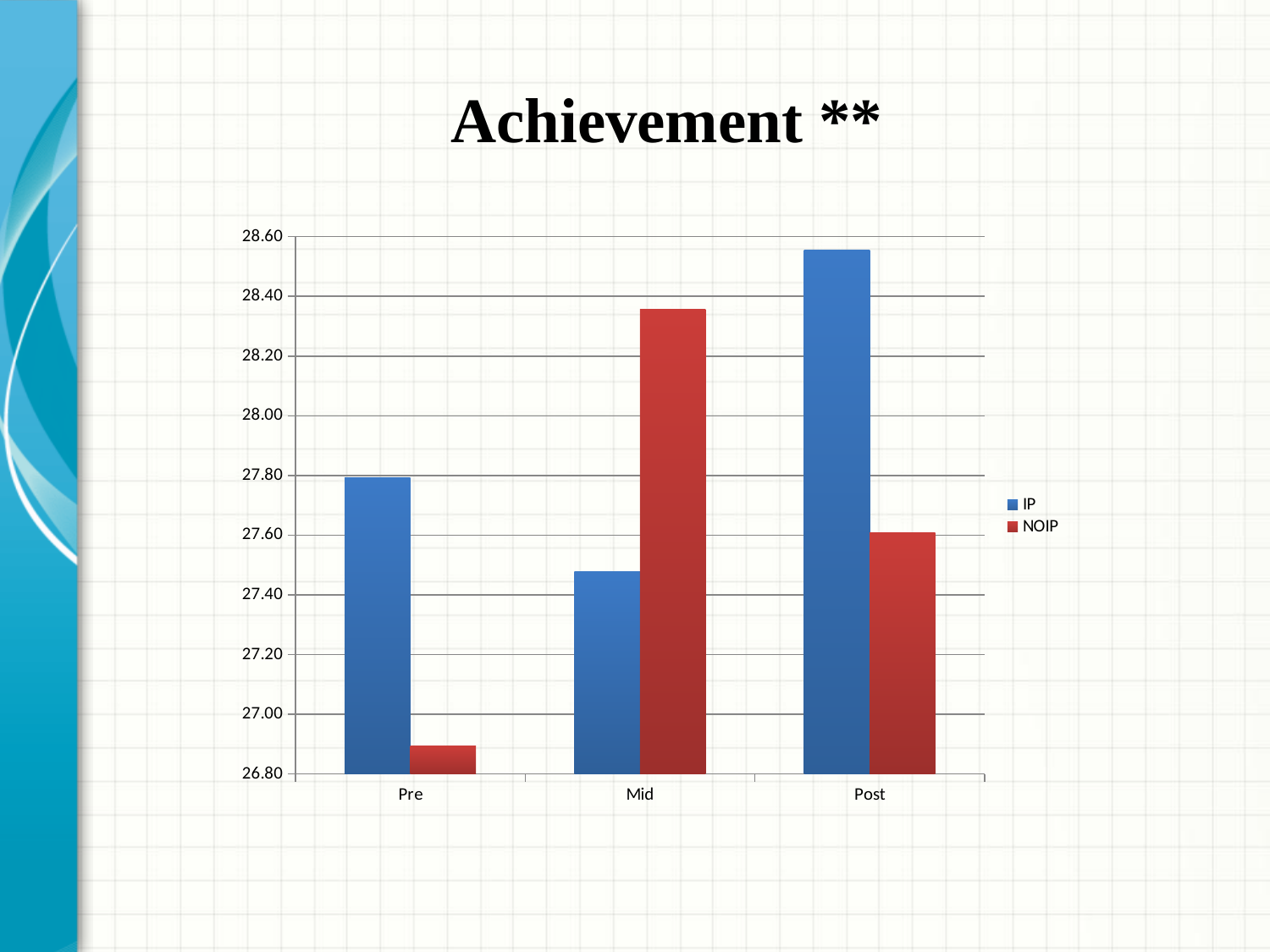
Which category has the highest value for the IP series? Post Is the value for NOIP at Pre greater or less than 27.00? less Which category has the lowest value for the NOIP series? Pre At Post, which series has the larger value, IP or NOIP? IP Which category has the lowest value for the IP series? Mid What kind of chart is shown on the slide? bar chart At Mid, which series has the larger value, IP or NOIP? NOIP What is the title of the chart? Achievement ** Is the value for IP at Post greater or less than 28.40? greater How many categories are shown on the x axis? 3 How many series does the legend list? 2 Which category has the highest value for the NOIP series? Mid